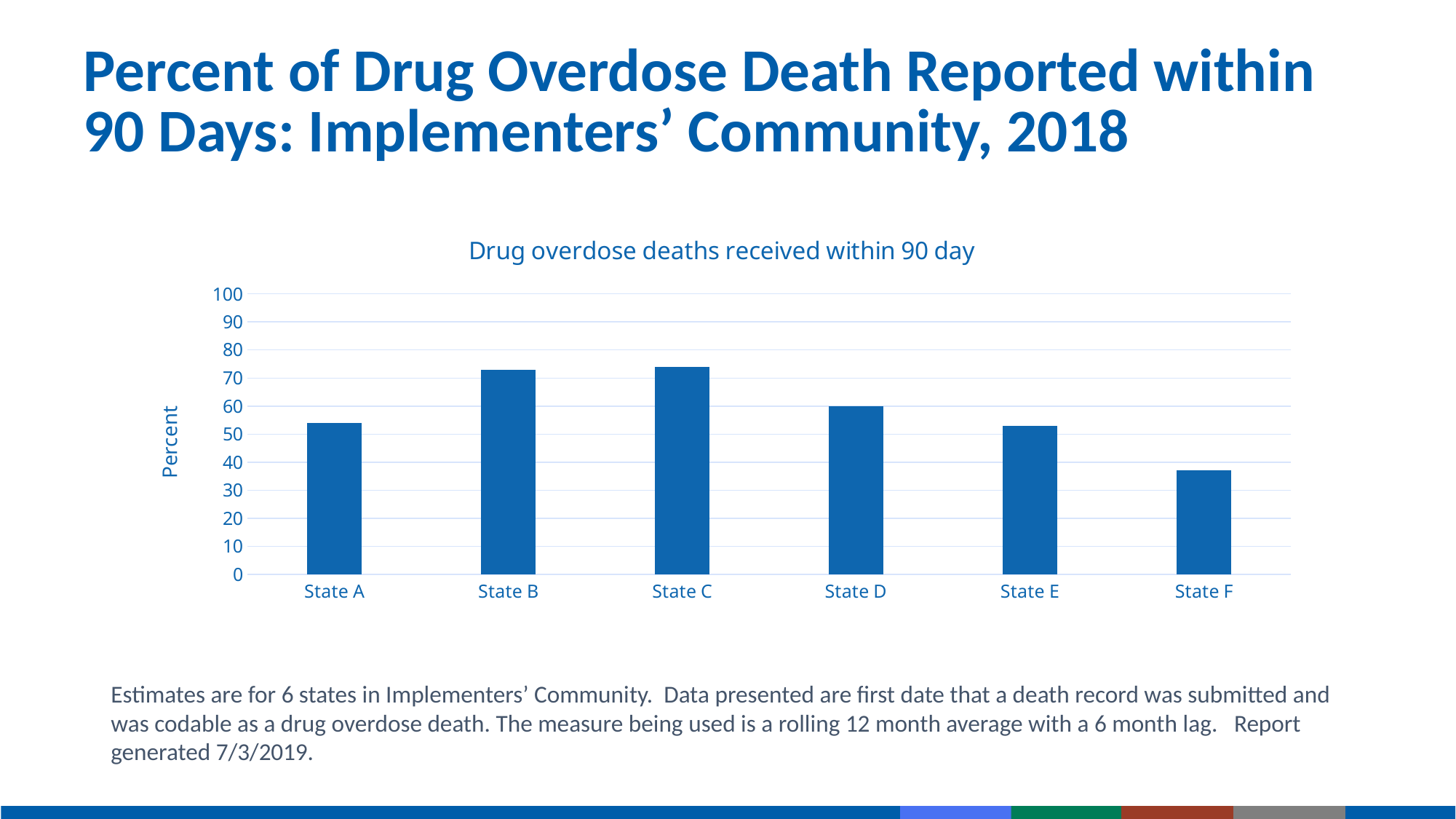
What is the label on the y axis of the chart? Percent What is the title of the chart? Drug overdose deaths received within 90 day Which is larger, the value for State B or the value for State D? State B Which is larger, the value for State E or the value for State F? State E Is the value for State E greater or less than 60? less Is the value for State C greater or less than 80? less How many states are shown on the x axis of the chart? 6 Is the value for State A greater or less than 50? greater Which state has the lowest percent of drug overdose deaths received within 90 days? State F What kind of chart is shown on the slide? bar chart